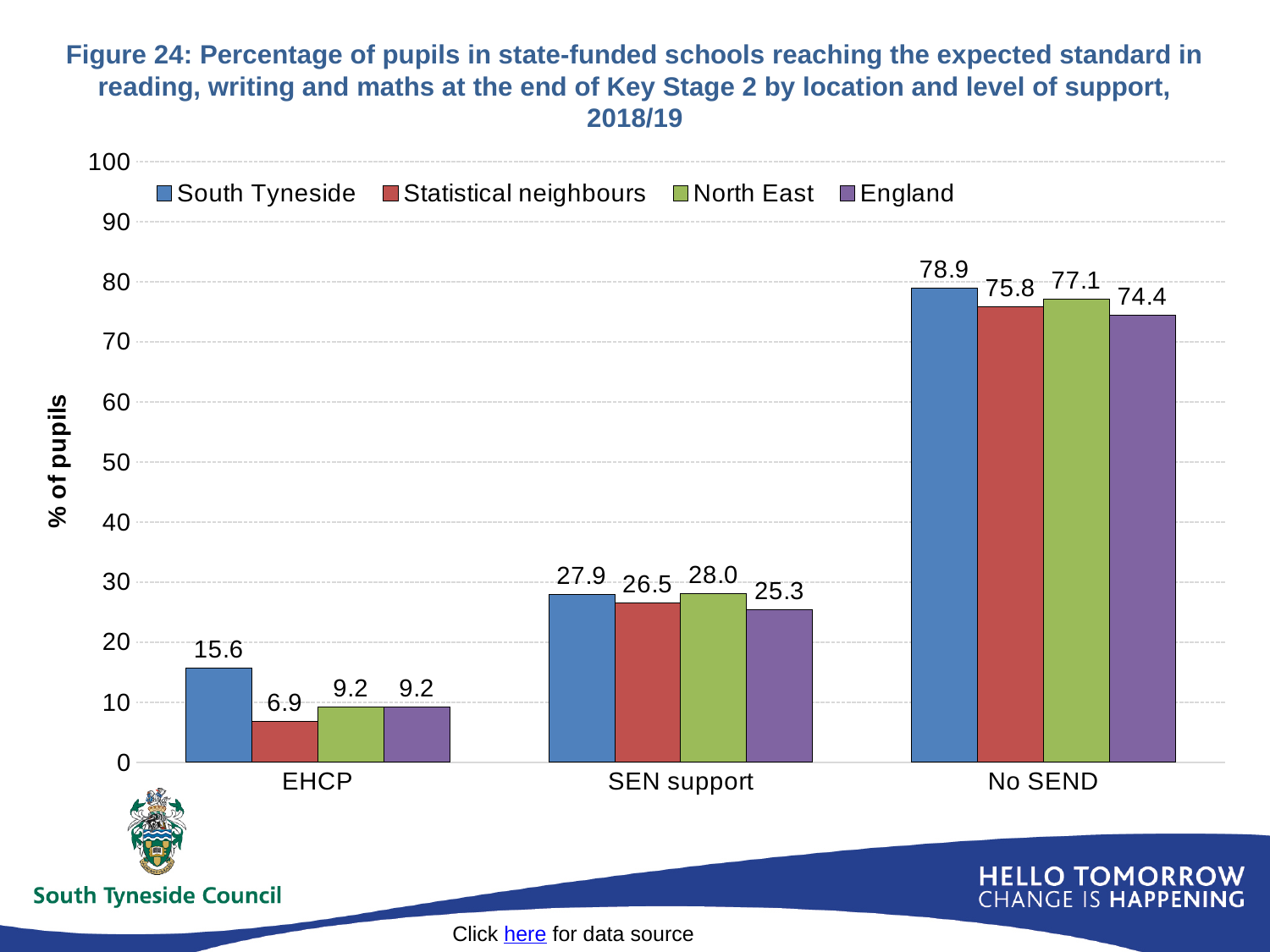
What is the label of the y axis? % of pupils What kind of chart is shown on the slide? Bar chart What is the value for Statistical neighbours in the No SEND category? 75.8 Which series has the highest value in the No SEND category? South Tyneside Which series has the lowest value in the EHCP category? Statistical neighbours How many series does the legend list? 4 What is the value for South Tyneside in the EHCP category? 15.6 Which is larger in the SEN support category: North East or Statistical neighbours? North East How many categories are shown on the x axis? 3 Do the South Tyneside values rise or fall from EHCP to No SEND? Rise What is the value for England in the SEN support category? 25.3 What is the difference between the South Tyneside and England values in the No SEND category? 4.5